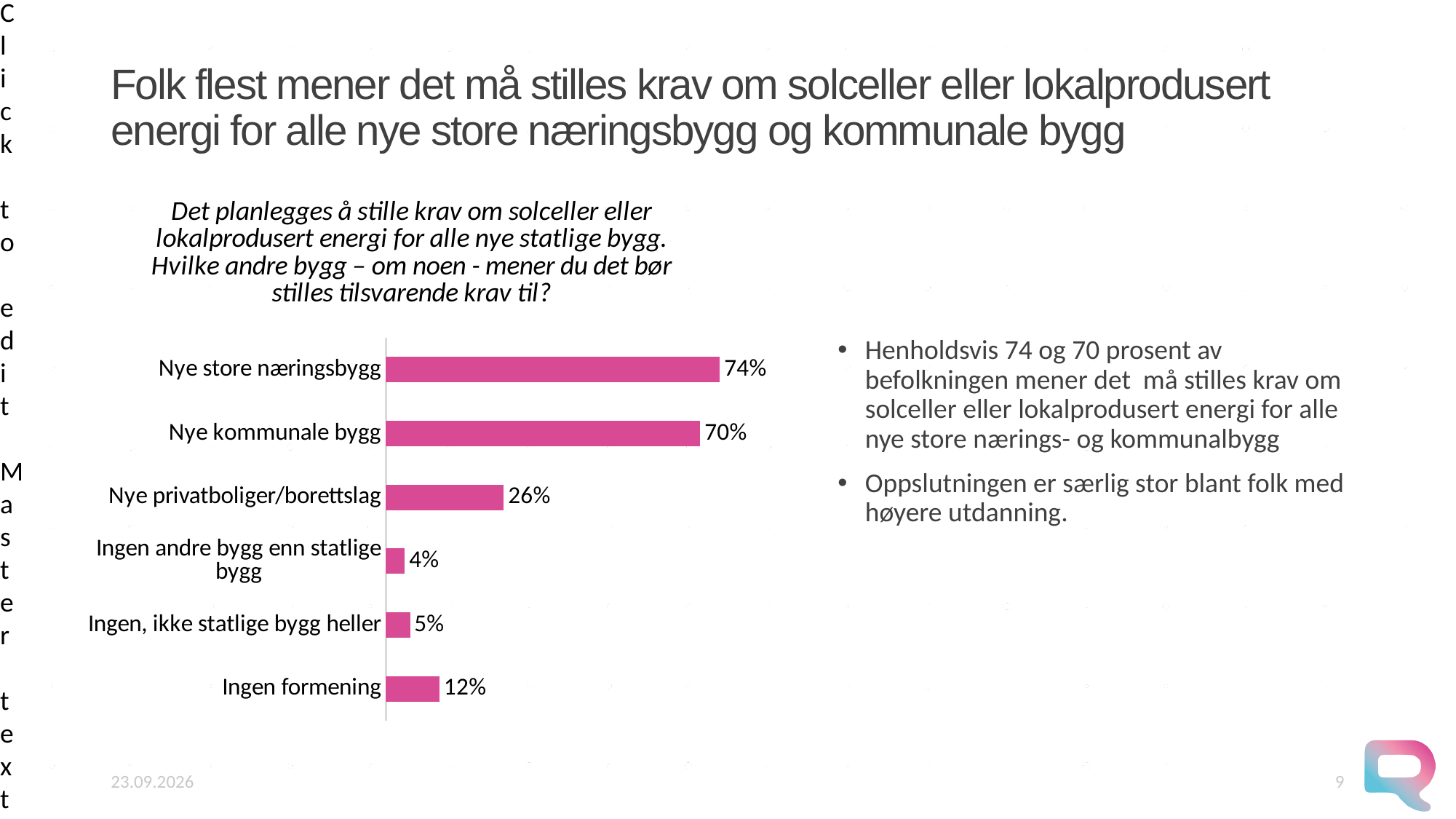
Which is larger, the value for Ingen formening or the value for Ingen, ikke statlige bygg heller? Ingen formening Which category has the highest value? Nye store næringsbygg What is the value for Ingen, ikke statlige bygg heller? 5% What is the difference between the values for Nye kommunale bygg and Nye privatboliger/borettslag? 44% What is the value for Nye privatboliger/borettslag? 26% What kind of chart is shown on the slide? Bar chart What is the difference between the values for Nye store næringsbygg and Nye kommunale bygg? 4% Which category has the lowest value? Ingen andre bygg enn statlige bygg What is the value for Nye store næringsbygg? 74% How many categories are shown in the chart? 6 What is the value for Ingen formening? 12% What colour are the bars in the chart? Pink